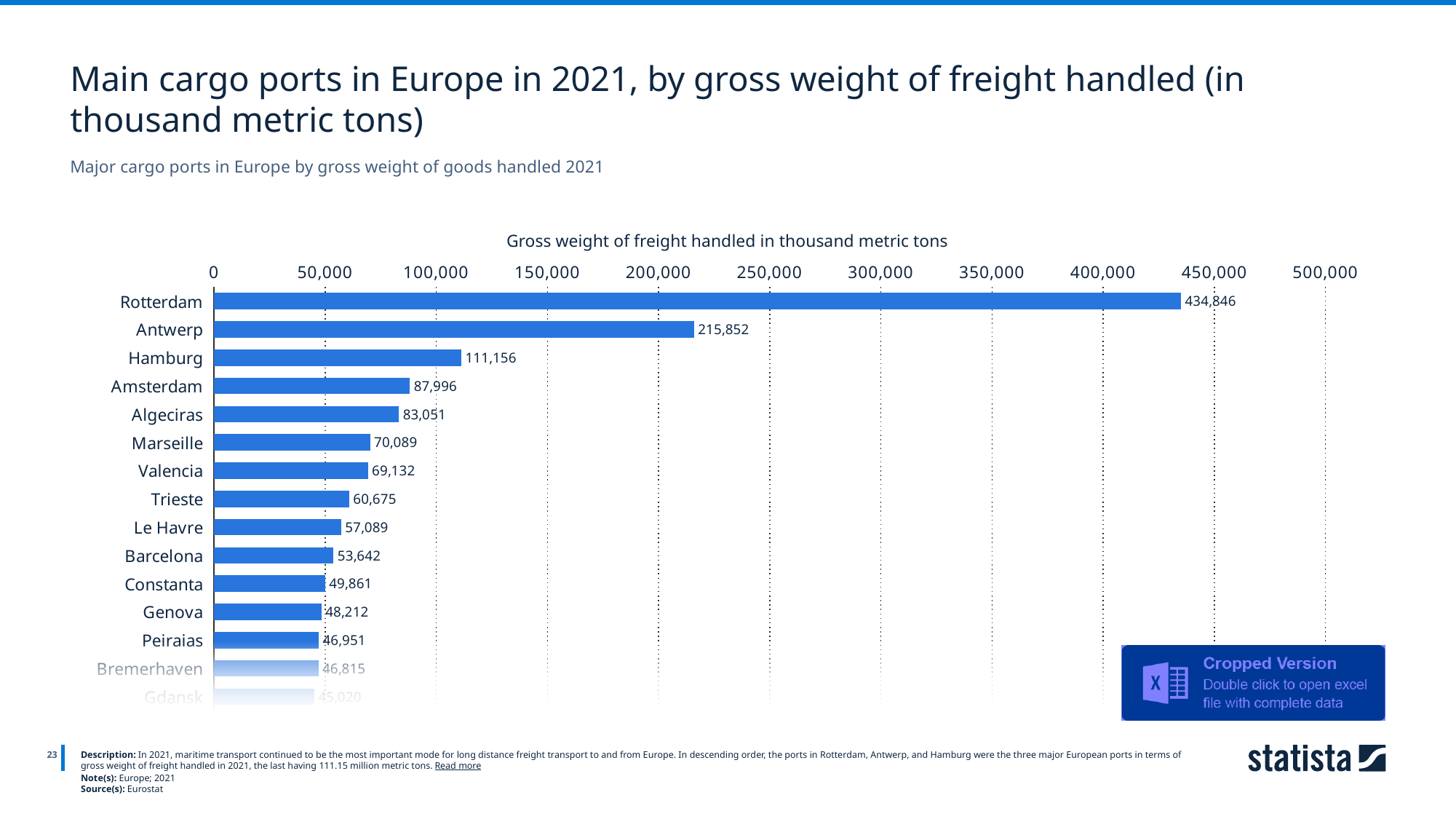
What is the value shown for Algeciras? 83,051 What is the difference between the values for Rotterdam and Antwerp? 218,994 What kind of chart is shown on the slide? Bar chart What is the axis title shown above the chart? Gross weight of freight handled in thousand metric tons Which port has a larger value, Marseille or Trieste? Marseille Is the value for Hamburg greater or less than 100,000? greater What is the value shown for Hamburg? 111,156 Which port has the highest gross weight of freight handled? Rotterdam What is the gross weight of freight handled by Rotterdam? 434,846 What is the value shown for Antwerp? 215,852 What is the difference between the values for Amsterdam and Algeciras? 4,945 What is the value shown for Le Havre? 57,089